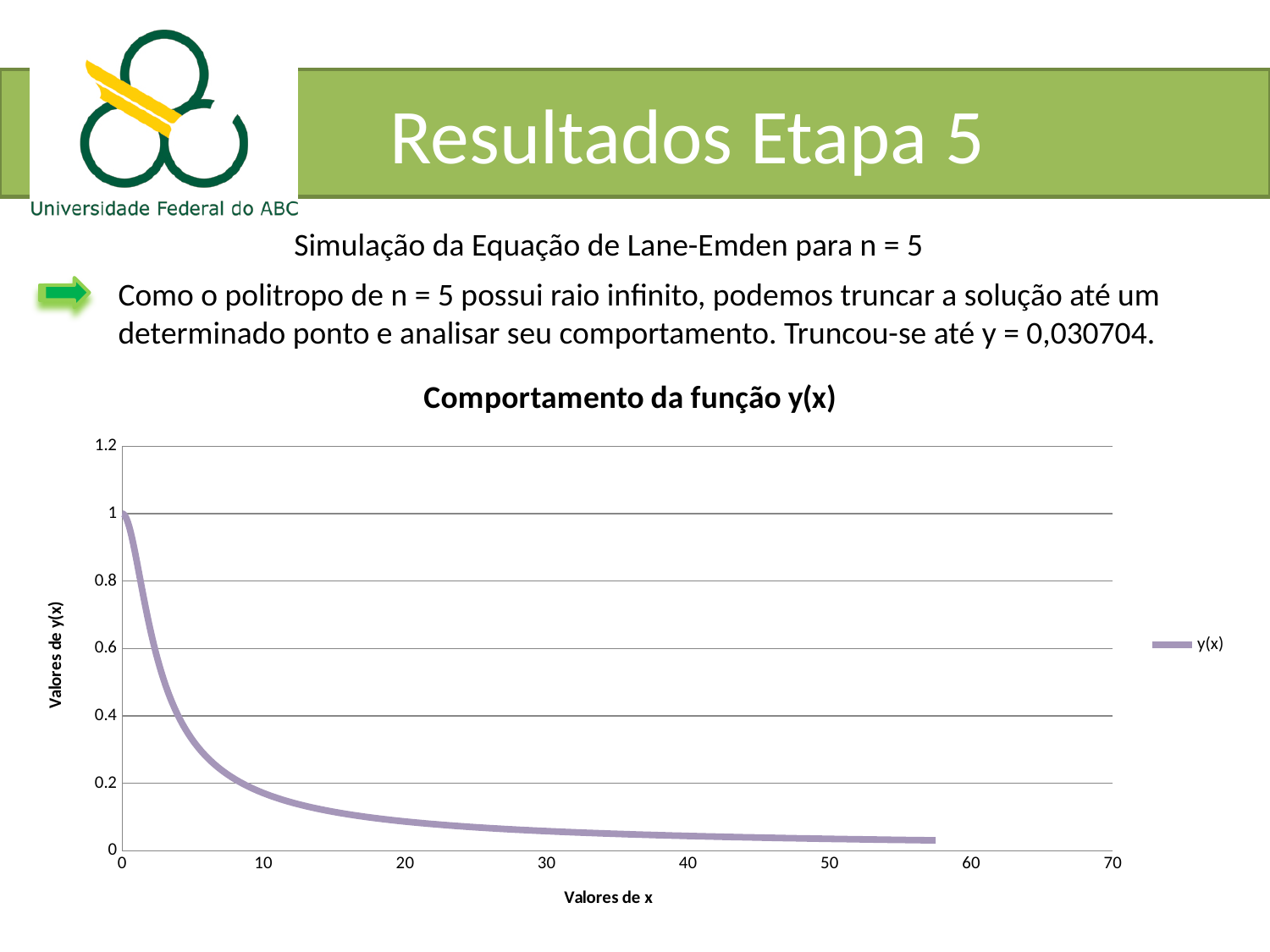
Is the value of y(x) at x = 5 greater or less than 0.2? greater How many series does the chart's legend list? 1 What kind of chart is shown on the slide? line chart Is the value of y(x) at x = 10 greater or less than 0.4? less At which value of x is y(x) highest? 0 Is the value of y(x) at x = 20 greater or less than 0.2? less What is the value of y(x) at x = 0? 1 Which is larger, the value of y(x) at x = 10 or at x = 50? x = 10 What is the title of the chart? Comportamento da função y(x) What is the name of the series shown in the legend? y(x) Do the values of y(x) rise or fall as x increases along the x axis? fall